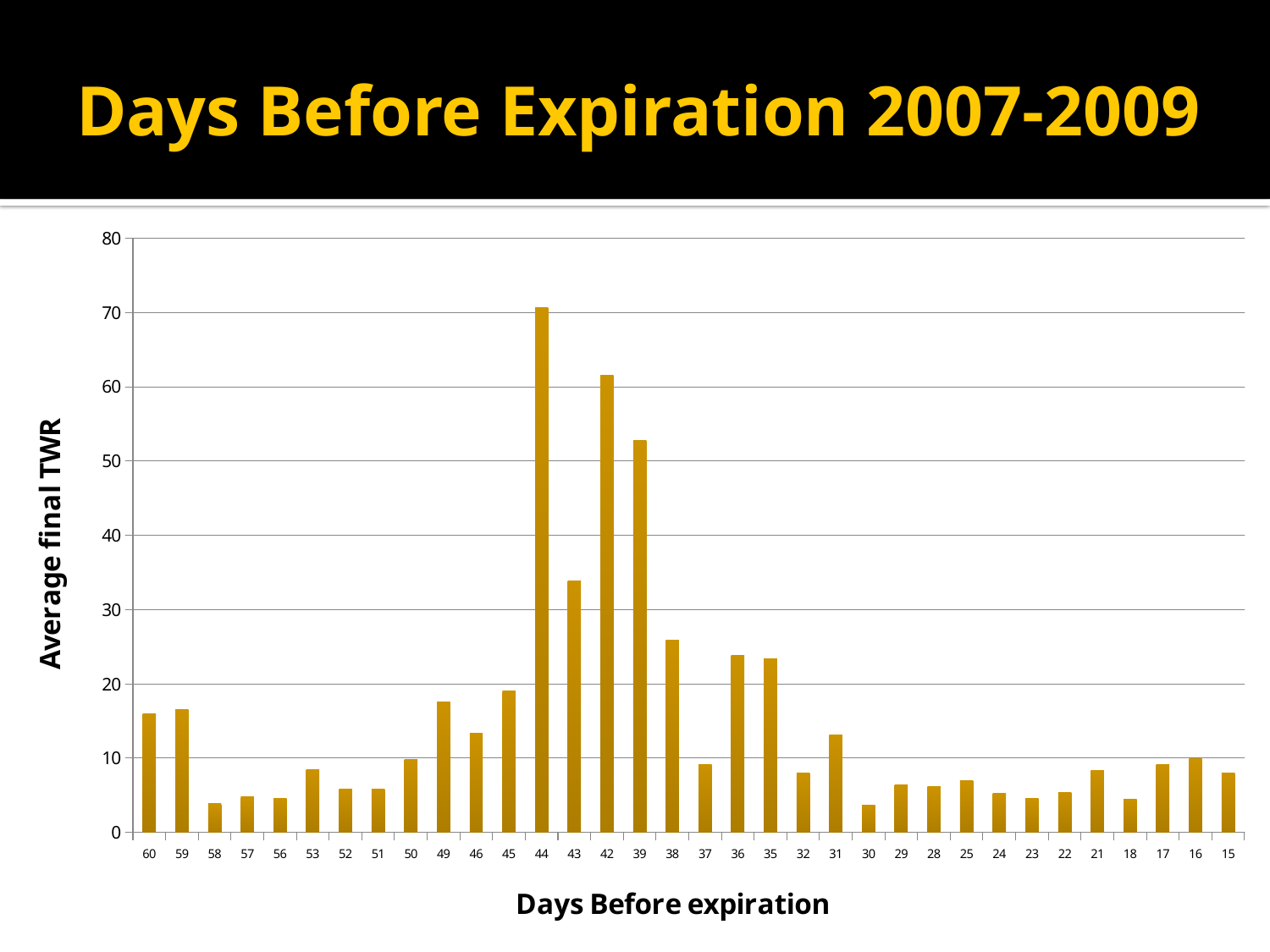
How many days-before-expiration categories are plotted on the x axis? 34 Is the value for 44 days before expiration greater or less than 60? greater Which has a larger average final TWR, 42 days or 39 days before expiration? 42 What kind of chart is shown on the slide? bar chart What is the label of the vertical axis? Average final TWR Is the value for 38 days before expiration greater or less than 30? less Which day before expiration has the highest average final TWR? 44 Is the value for 49 days before expiration greater or less than 10? greater Which has a larger average final TWR, 43 days or 38 days before expiration? 43